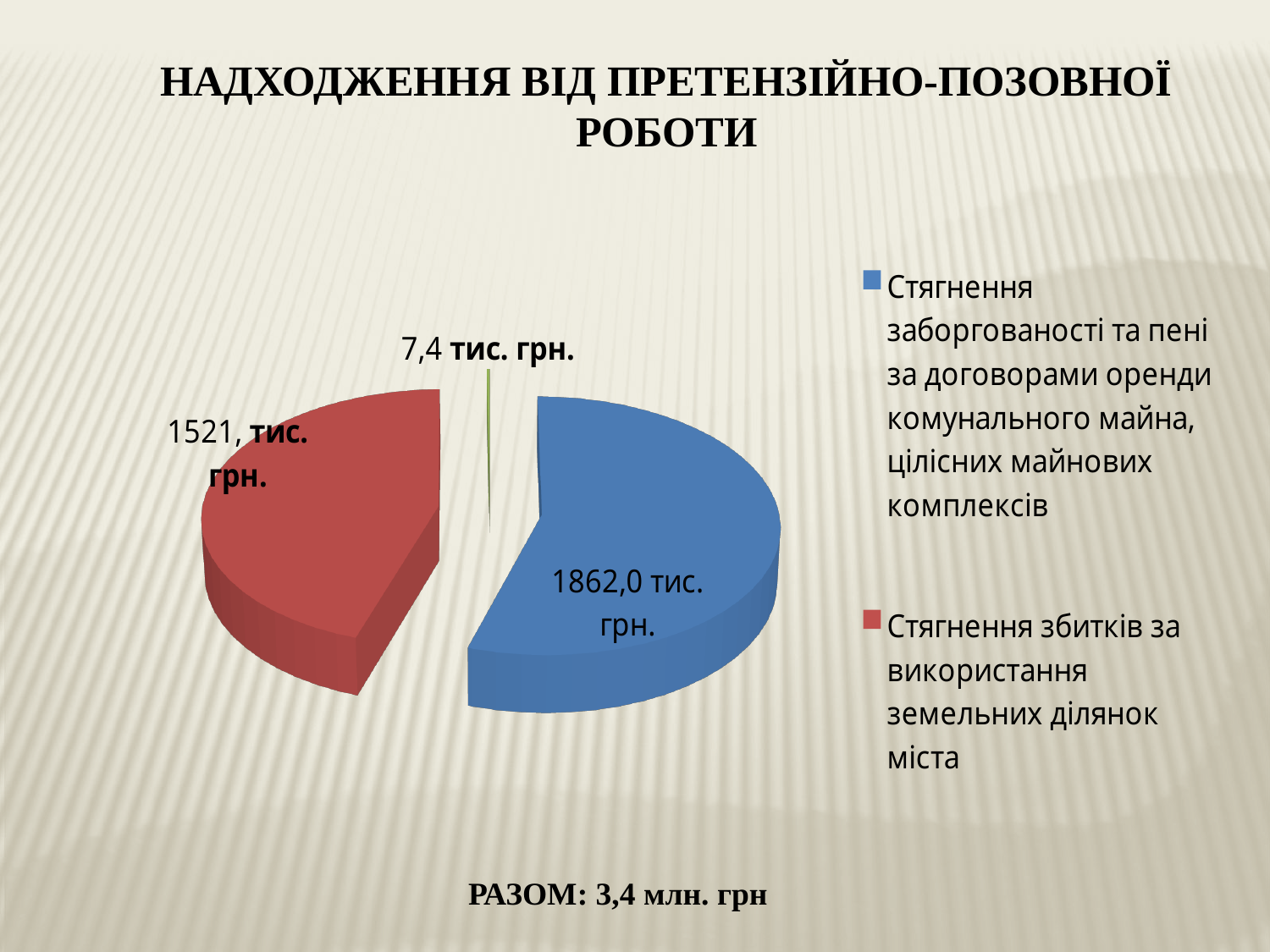
What total (РАЗОМ) is printed below the chart? 3,4 млн. грн What is the difference between the value for "Стягнення заборгованості та пені..." (1862,0 тис. грн.) and the value for "Стягнення збитків за використання земельних ділянок міста" (1521 тис. грн.)? 341 тис. грн. What colour is the slice for "Стягнення збитків за використання земельних ділянок міста"? red How many slices does the pie chart have? 3 Which is larger: the value for "Стягнення заборгованості та пені..." or the value for "Стягнення збитків за використання земельних ділянок міста"? Стягнення заборгованості та пені за договорами оренди комунального майна, цілісних майнових комплексів What is the value for "Стягнення збитків за використання земельних ділянок міста"? 1521 тис. грн. How many entries does the legend list? 2 What is the value for "Стягнення заборгованості та пені за договорами оренди комунального майна, цілісних майнових комплексів"? 1862,0 тис. грн. What is the smallest value labelled on the pie chart? 7,4 тис. грн. What kind of chart is shown on the slide? pie chart What is the title of the slide? НАДХОДЖЕННЯ ВІД ПРЕТЕНЗІЙНО-ПОЗОВНОЇ РОБОТИ Which legend category has the largest slice of the pie? Стягнення заборгованості та пені за договорами оренди комунального майна, цілісних майнових комплексів